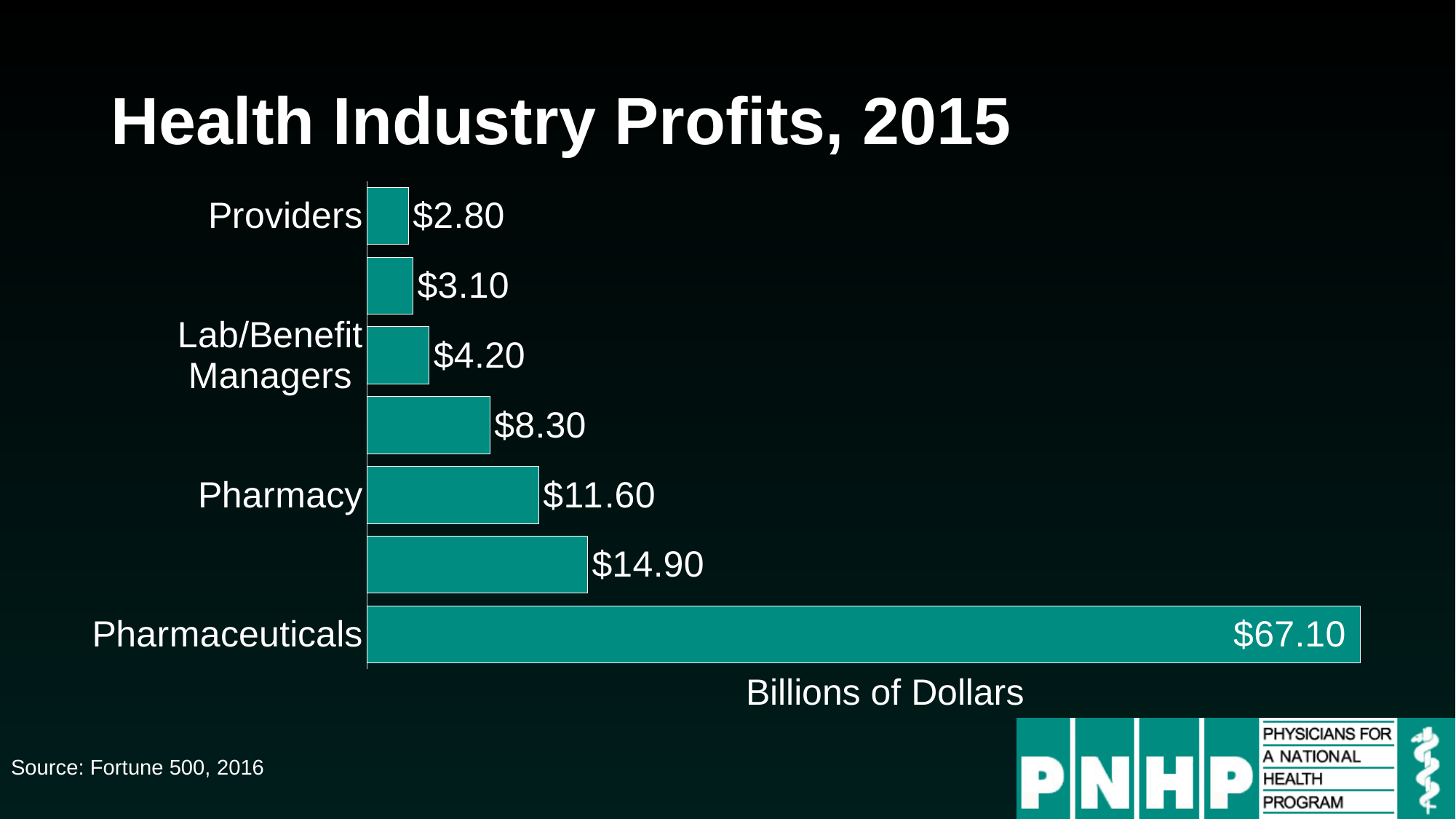
How many bars are plotted in the chart? 7 What is the difference between the values for Pharmaceuticals and Pharmacy? $55.50 What is the value for Providers? $2.80 Which category has the lowest profits? Providers Which category has the highest profits? Pharmaceuticals What unit is given on the horizontal axis label? Billions of Dollars What kind of chart is shown on the slide? Bar chart What is the value for Lab/Benefit Managers? $4.20 Which is larger, the value for Lab/Benefit Managers or the value for Providers? Lab/Benefit Managers What is the difference between the values for Pharmacy and Providers? $8.80 What is the value for Pharmaceuticals? $67.10 What is the value for Pharmacy? $11.60